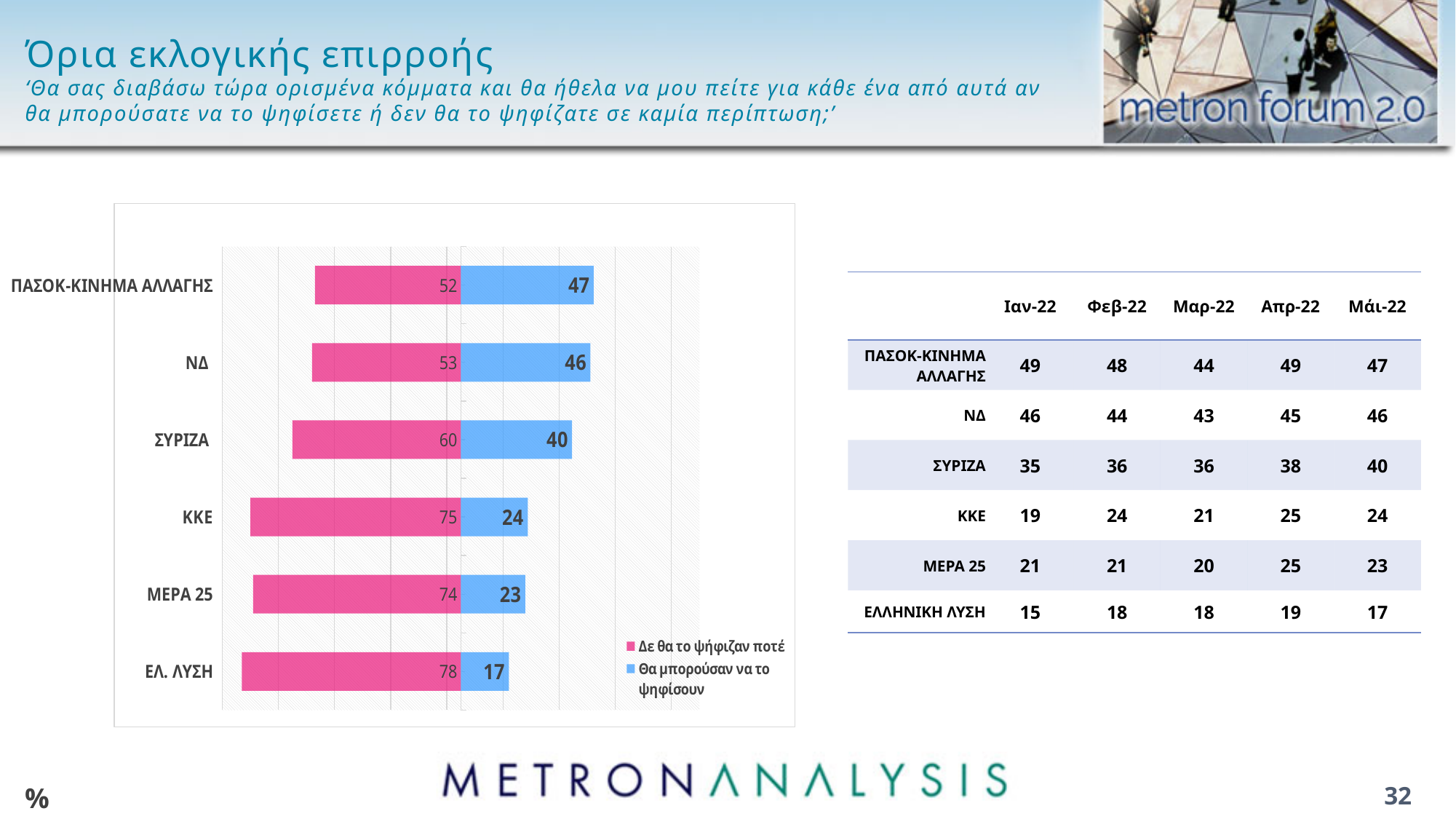
What is the value of 'Θα μπορούσαν να το ψηφίσουν' for ΕΛ. ΛΥΣΗ in the bar chart? 17 Which colour represents 'Δε θα το ψήφιζαν ποτέ' in the bar chart? Pink In the bar chart, which is larger: the 'Θα μπορούσαν να το ψηφίσουν' value for ΝΔ or for ΚΚΕ? ΝΔ Which party has the highest value for 'Θα μπορούσαν να το ψηφίσουν' in the bar chart? ΠΑΣΟΚ-ΚΙΝΗΜΑ ΑΛΛΑΓΗΣ What is the value of 'Θα μπορούσαν να το ψηφίσουν' for ΣΥΡΙΖΑ in the bar chart? 40 What type of chart is shown on the left of the slide? Bar chart Which party has the lowest value for 'Δε θα το ψήφιζαν ποτέ' in the bar chart? ΠΑΣΟΚ-ΚΙΝΗΜΑ ΑΛΛΑΓΗΣ How many parties are shown in the bar chart? 6 What is the value of 'Δε θα το ψήφιζαν ποτέ' for ΚΚΕ in the bar chart? 75 What is the difference between the 'Δε θα το ψήφιζαν ποτέ' values for ΕΛ. ΛΥΣΗ and ΣΥΡΙΖΑ in the bar chart? 18 Which party has the highest value for 'Δε θα το ψήφιζαν ποτέ' in the bar chart? ΕΛ. ΛΥΣΗ How many series does the legend of the bar chart list? 2